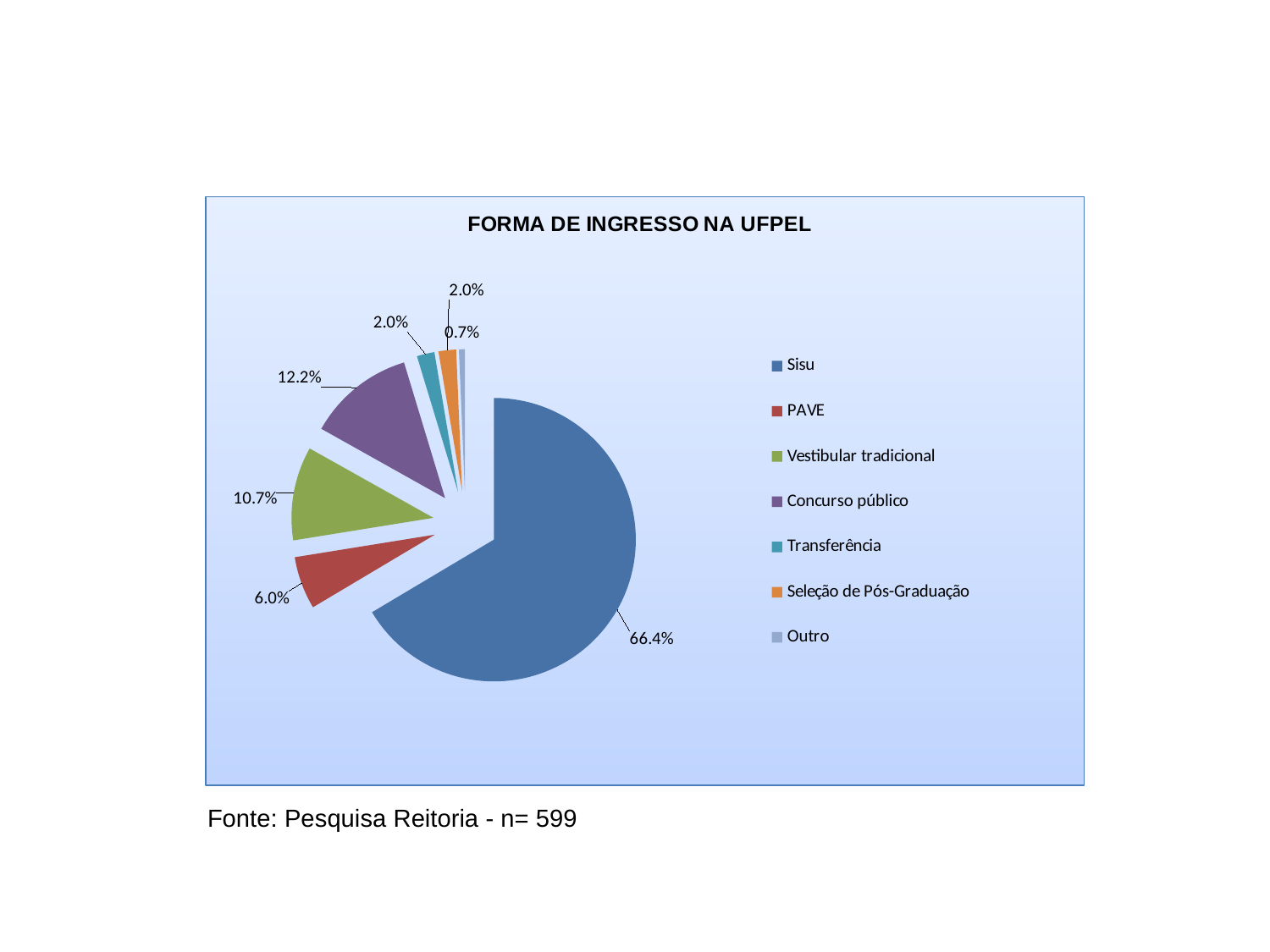
What is the value shown for Outro? 0.7% Which category has the smallest share of the pie? Outro What is the value shown for Vestibular tradicional? 10.7% What is the difference between the shares of Concurso público and Vestibular tradicional? 1.5% What type of chart is shown on the slide? pie chart What share of the pie does Sisu represent? 66.4% What is the title of the chart? FORMA DE INGRESSO NA UFPEL Which is larger, the share for PAVE or the share for Vestibular tradicional? Vestibular tradicional Which category has the largest share of the pie? Sisu What is the value shown for PAVE? 6.0% How many categories does the legend list? 7 What is the value shown for Concurso público? 12.2%